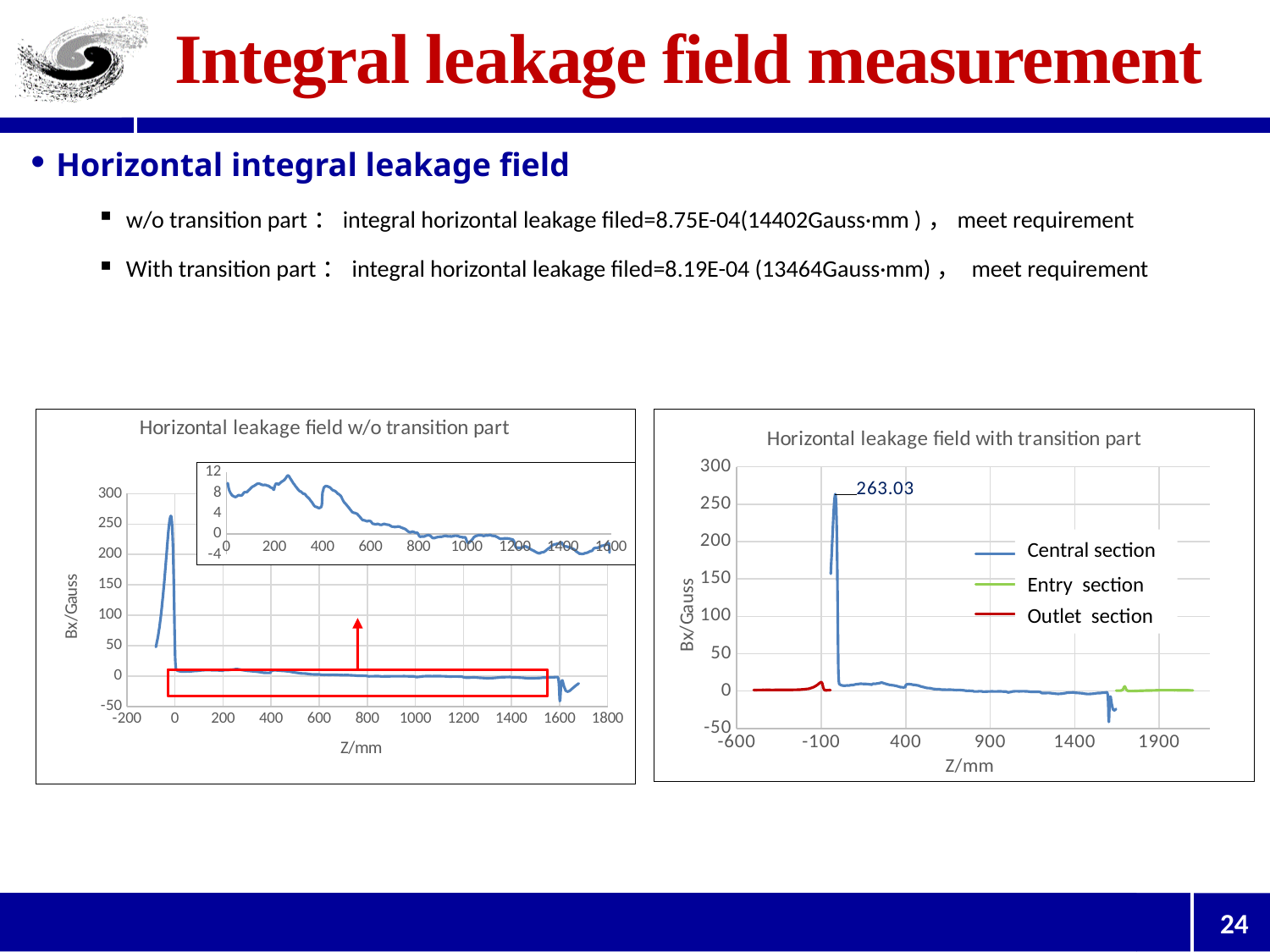
What is the title of the chart on the left of the slide? Horizontal leakage field w/o transition part In the 'Horizontal leakage field with transition part' chart, what is the labelled peak value of the Central section series? 263.03 In the 'Horizontal leakage field with transition part' chart, is the peak value of the Central section greater or less than 250? greater What kind of chart is the 'Horizontal leakage field w/o transition part' chart? line chart In the 'Horizontal leakage field w/o transition part' chart, is the value at Z=1000 greater or less than 50? less In the 'Horizontal leakage field with transition part' chart, which series reaches the highest value? Central section In the 'Horizontal leakage field with transition part' chart, is the peak of the Central section larger or smaller than the peak of the Outlet section? larger In the 'Horizontal leakage field with transition part' chart, is the peak value of the Central section greater or less than 300? less In the 'Horizontal leakage field with transition part' chart, which series is drawn in red? Outlet section How many series does the legend of the 'Horizontal leakage field with transition part' chart list? 3 In the 'Horizontal leakage field with transition part' chart, does the Central section series rise or fall along the x axis after its peak near Z=0? fall